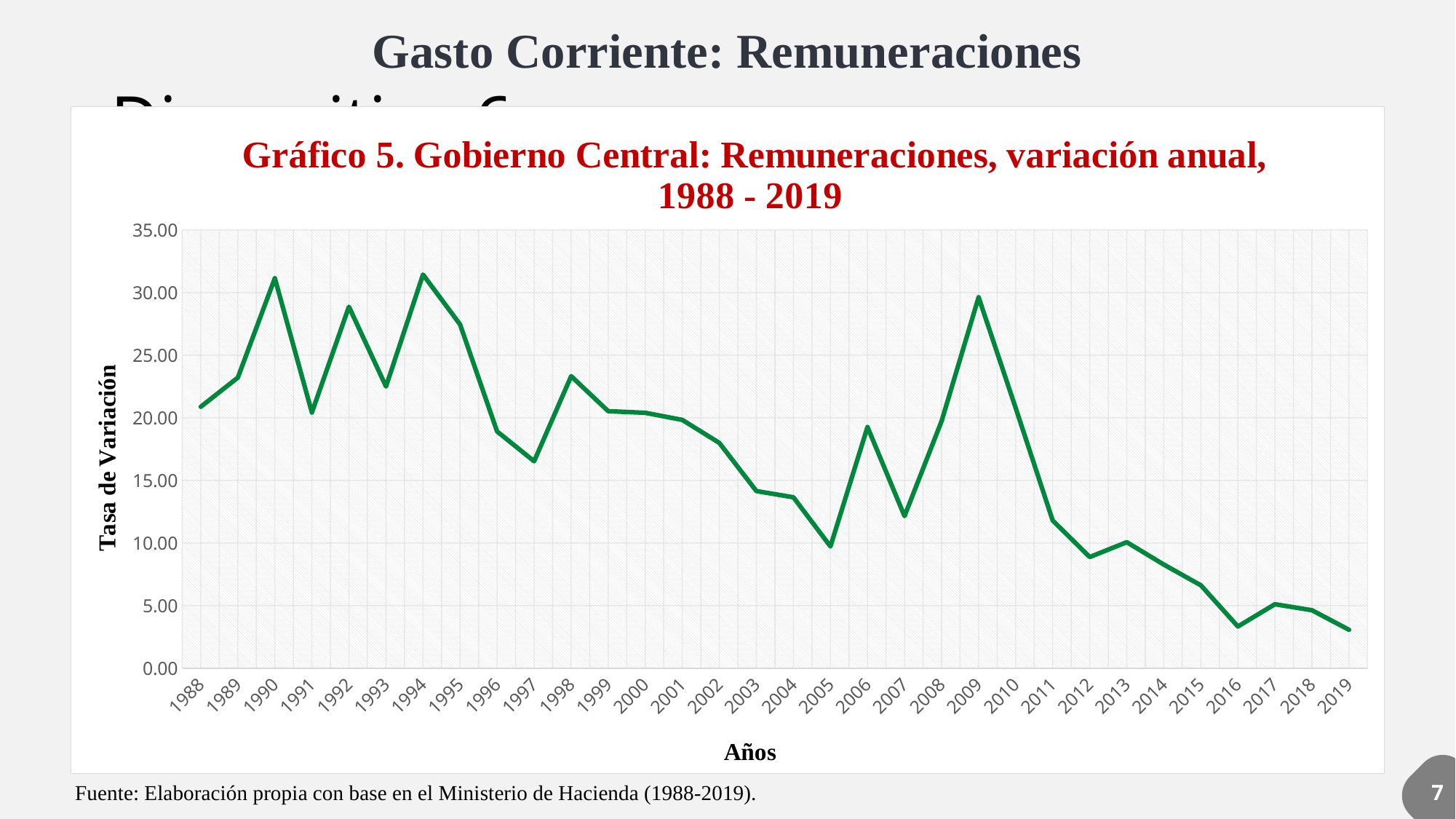
Overall, do the values rise or fall from 1988 to 2019? fall Is the value for 1997 greater or less than 20.00? less Which year has the larger value, 2009 or 2006? 2009 Which year has the larger value, 1992 or 1993? 1992 Is the value for 2012 greater or less than 10.00? less What kind of chart is shown on the slide? line chart Is the value for 2009 greater or less than 25.00? greater What is the title of the chart? Gráfico 5. Gobierno Central: Remuneraciones, variación anual, 1988 - 2019 What is the label of the y axis? Tasa de Variación How many years are plotted along the x axis? 32